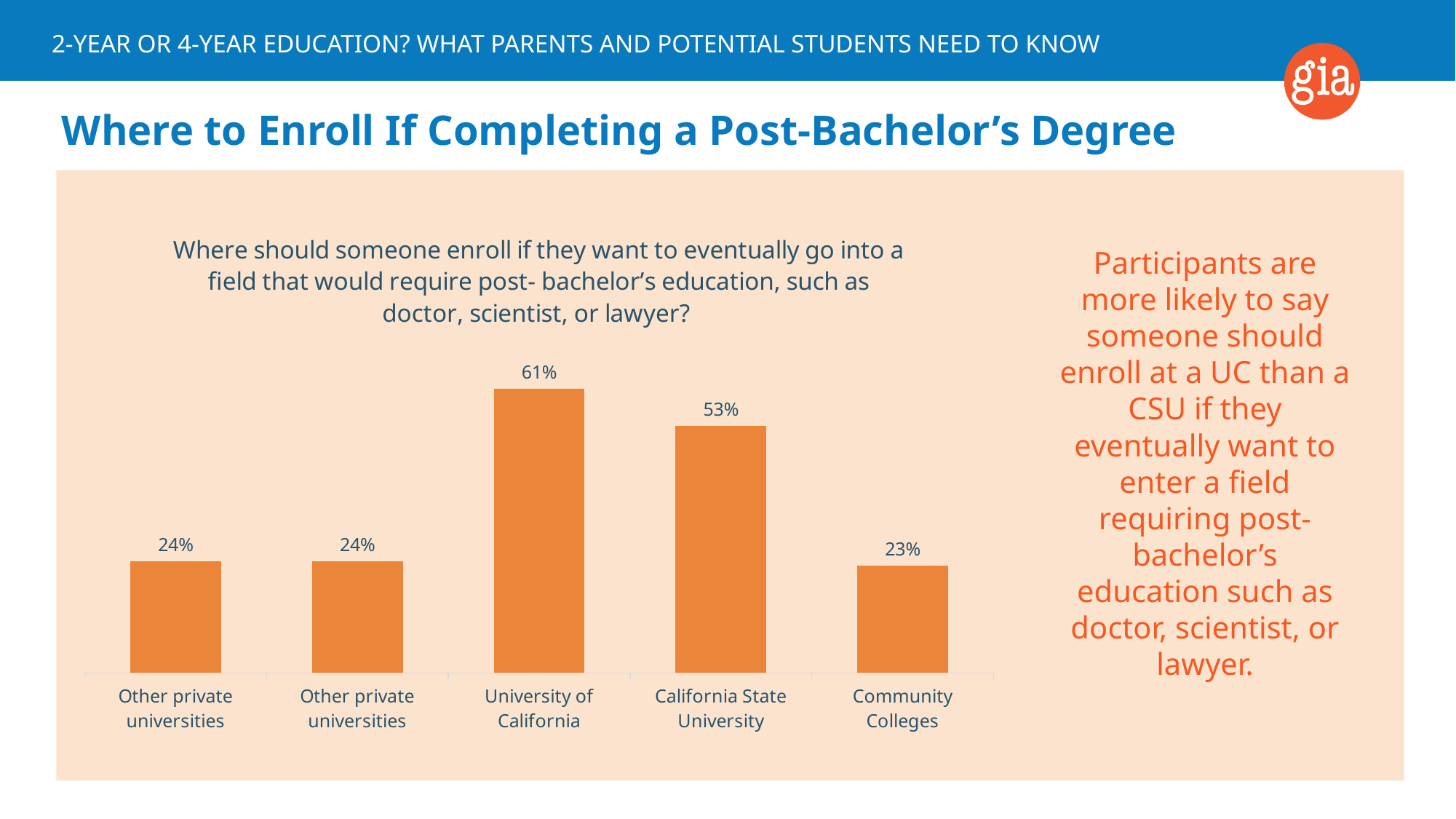
Which is larger, the value for University of California or the value for California State University? University of California What percentage of participants said someone should enroll at the University of California? 61% What is the value shown for California State University? 53% What colour are the bars in the chart? Orange What is the difference between the values for California State University and Community Colleges? 30% What value is shown for Other private universities? 24% Which category has the highest value in the chart? University of California How many bars are shown in the chart? 5 What percentage is shown for Community Colleges? 23% Which category has the lowest value in the chart? Community Colleges What is the difference between the values for University of California and California State University? 8% What type of chart is shown on the slide? Bar chart